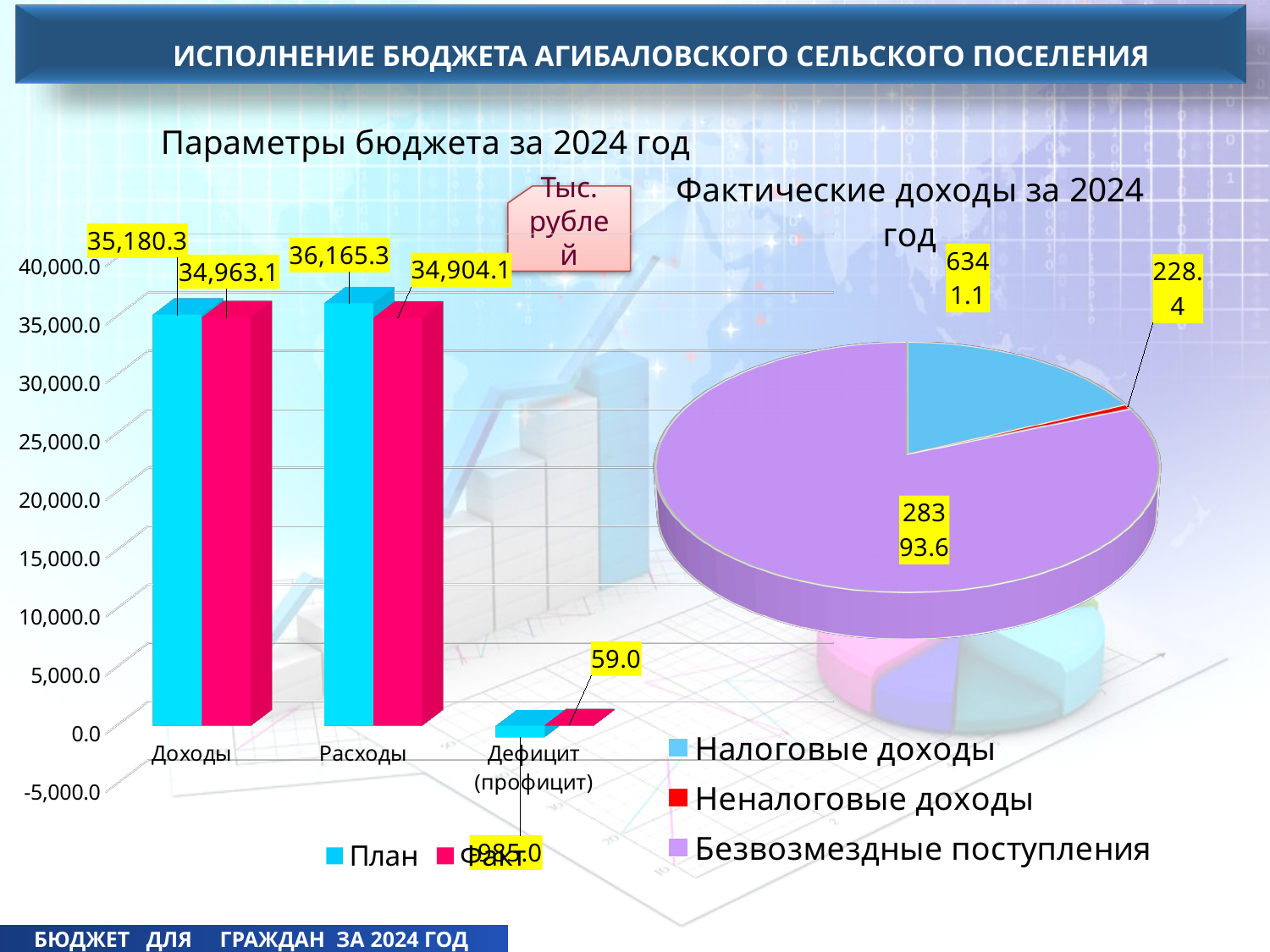
In the bar chart 'Параметры бюджета за 2024 год', what is the План value for Доходы? 35,180.3 What type of chart is 'Параметры бюджета за 2024 год'? Bar chart In the bar chart 'Параметры бюджета за 2024 год', which is larger: the План value for Доходы or the План value for Расходы? Расходы In the pie chart 'Фактические доходы за 2024 год', which category has the smallest slice? Неналоговые доходы In the bar chart 'Параметры бюджета за 2024 год', what is the difference between the План and Факт values for Доходы? 217.2 In the bar chart 'Параметры бюджета за 2024 год', how many series does the legend list? 2 In the bar chart 'Параметры бюджета за 2024 год', what is the Факт value for Дефицит (профицит)? 59.0 In the pie chart 'Фактические доходы за 2024 год', what is the value for Неналоговые доходы? 228.4 In the bar chart 'Параметры бюджета за 2024 год', what is the Факт value for Расходы? 34,904.1 In the bar chart 'Параметры бюджета за 2024 год', how many categories are shown on the x axis? 3 In the pie chart 'Фактические доходы за 2024 год', which category has the largest slice? Безвозмездные поступления In the bar chart 'Параметры бюджета за 2024 год', what is the difference between the План and Факт values for Расходы? 1,261.2